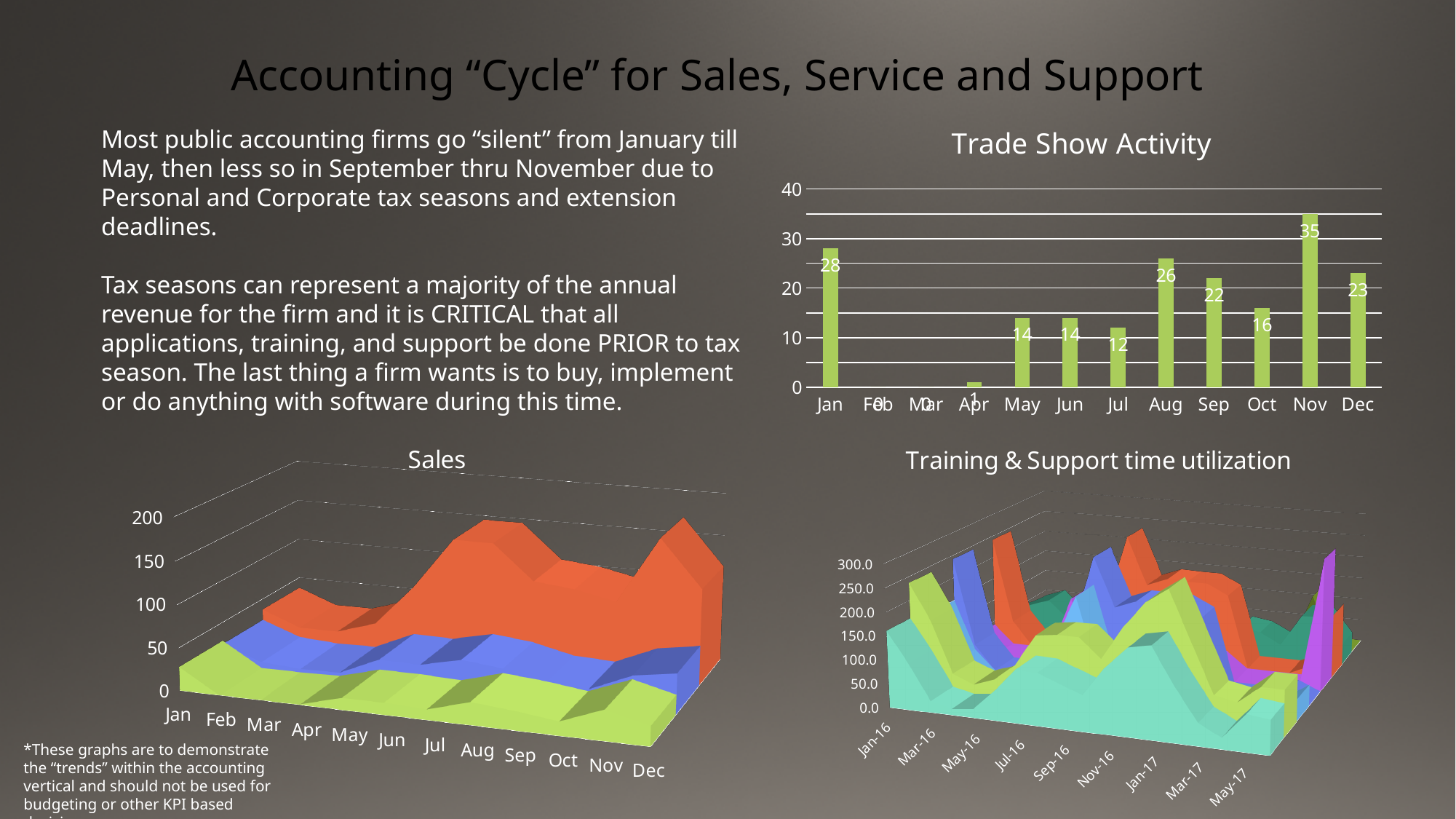
What kind of chart is the Sales chart at the bottom left of the slide? area chart How many months are shown on the x axis of the Trade Show Activity chart? 12 In the Trade Show Activity chart, what is the value for Nov? 35 In the Trade Show Activity chart, what is the difference between the values for Aug and Sep? 4 In the Trade Show Activity chart, which is larger, the value for Sep or the value for Dec? Dec In the Trade Show Activity chart, what is the value for Oct? 16 In the Trade Show Activity chart, is the value for Jul greater or less than 20? less In the Trade Show Activity chart, what is the value for Jan? 28 What is the title of the chart at the bottom right of the slide? Training & Support time utilization What kind of chart is the Trade Show Activity chart? bar chart In the Trade Show Activity chart, what is the difference between the values for Nov and Jan? 7 In the Trade Show Activity chart, which month has the highest value? Nov